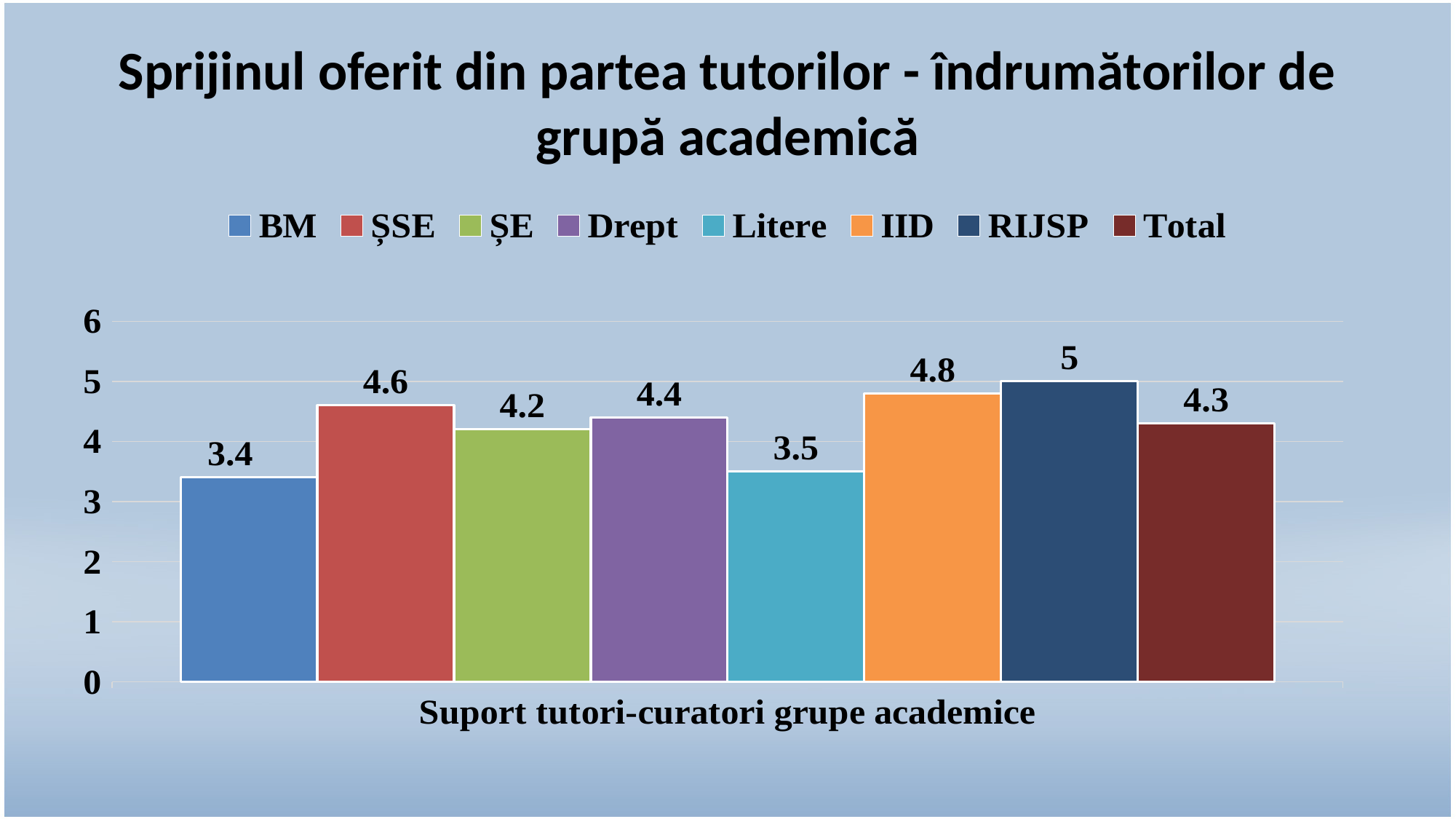
What colour is the bar for Litere? Teal What is the value for Litere? 3.5 Which series has the highest value? RIJSP What is the value for Total? 4.3 What kind of chart is shown on the slide? Bar chart What is the label shown on the x axis below the bars? Suport tutori-curatori grupe academice What is the value for RIJSP? 5 What is the value for BM? 3.4 How many series does the legend list? 8 Which is larger, the value for Drept or the value for IID? IID Which series has the lowest value? BM What is the difference between the values for ȘSE and ȘE? 0.4